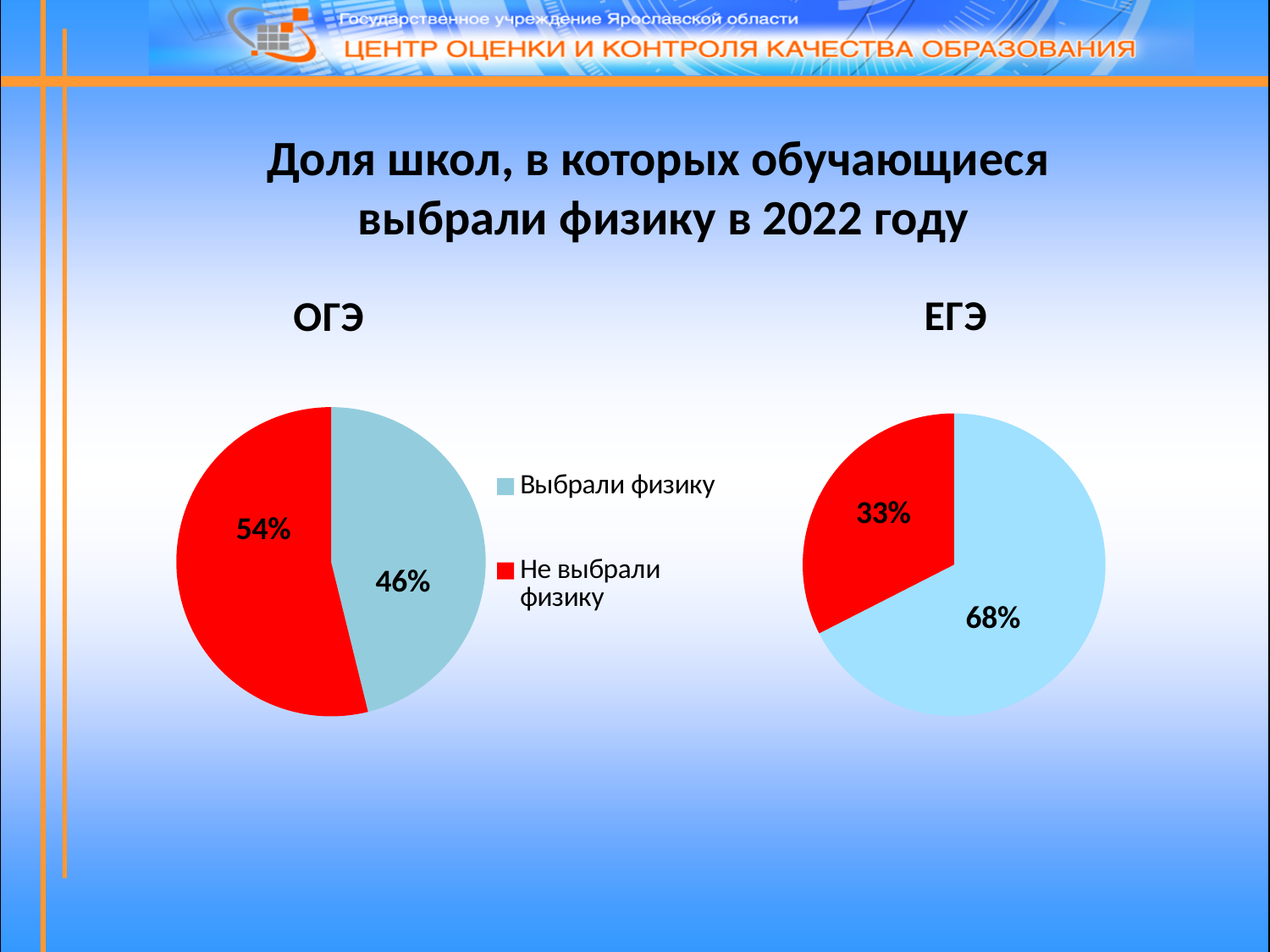
In the ЕГЭ chart, what share of schools chose physics (Выбрали физику)? 68% In the ОГЭ chart, what share of schools chose physics (Выбрали физику)? 46% In the ОГЭ chart, which slice is larger: Выбрали физику or Не выбрали физику? Не выбрали физику How many slices does the ЕГЭ pie chart have? 2 In the ЕГЭ chart, what share of schools did not choose physics (Не выбрали физику)? 33% In the ЕГЭ chart, which slice is the smallest? Не выбрали физику Which colour represents Не выбрали физику in the legend? Red In the ОГЭ chart, what share of schools did not choose physics (Не выбрали физику)? 54% Which chart shows a larger share of schools that chose physics, ОГЭ or ЕГЭ? ЕГЭ What type of chart is used for the ОГЭ data? Pie chart What is the difference between the Не выбрали физику share in the ОГЭ chart and the Не выбрали физику share in the ЕГЭ chart? 21 percentage points How many entries does the legend list? 2